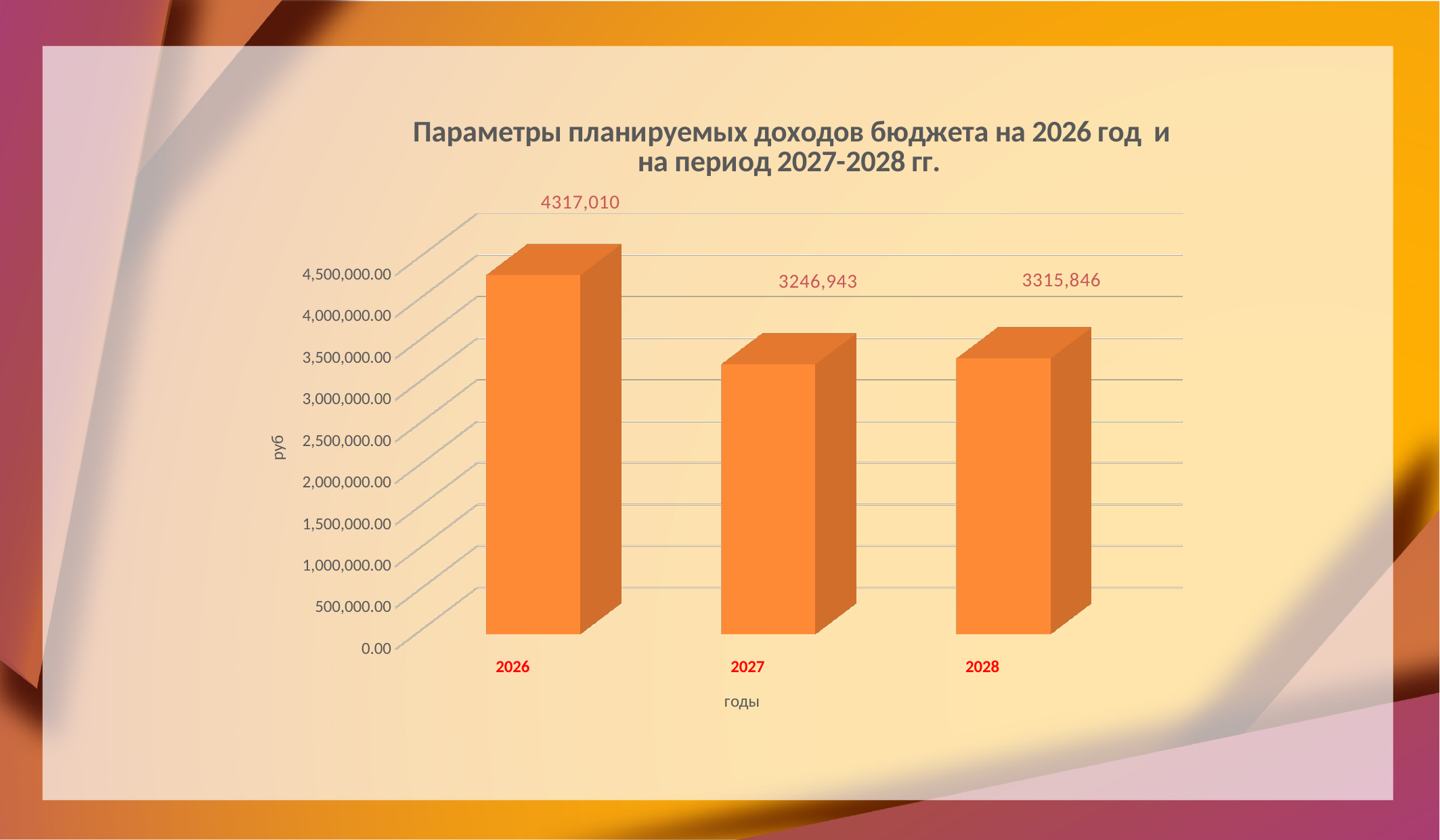
Which is larger, the value for 2027 or the value for 2028? 2028 Is the bar for 2026 greater or less than 4,000,000.00 on the axis? greater Which year has the highest planned budget income? 2026 What is the difference between the data labels for 2028 and 2027? 68,903 What is the label of the vertical axis? руб What is the data label for 2028? 3315,846 What is the difference between the data labels for 2026 and 2027? 1070,067 What kind of chart is shown on the slide? bar chart What is the data label for 2026? 4317,010 Which year has the lowest planned budget income? 2027 What is the data label for 2027? 3246,943 How many years are shown on the x axis? 3